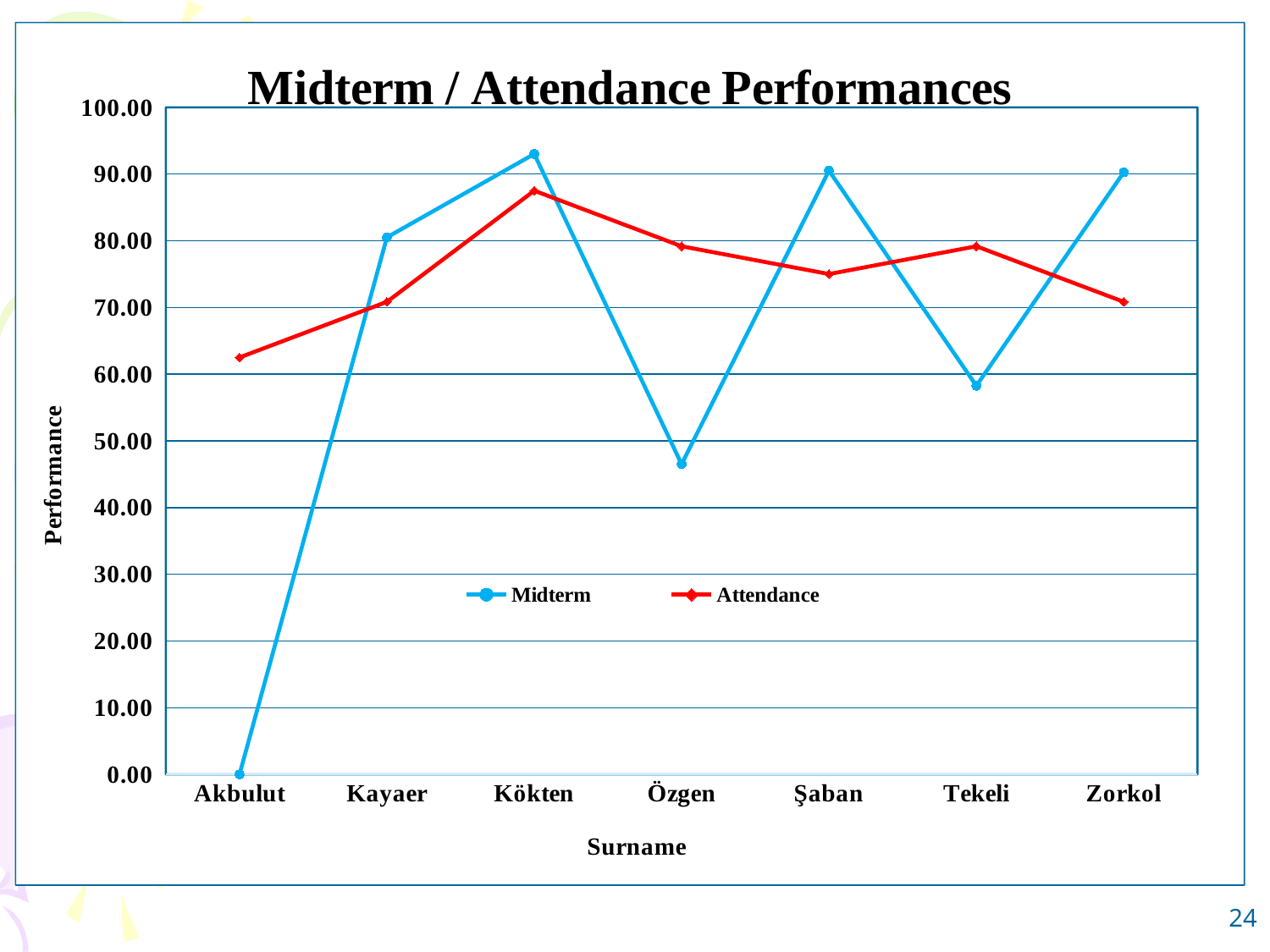
How many series does the legend list? 2 How many surnames are shown on the x axis? 7 For Özgen, which is larger: the Midterm value or the Attendance value? Attendance Is the Midterm value for Özgen greater or less than 50.00? less Which surname has the lowest Midterm value? Akbulut Which surname has the highest Midterm value? Kökten What is the title of the chart? Midterm / Attendance Performances Is the Attendance value for Kökten greater or less than 80.00? greater What is the Midterm value for Akbulut? 0.00 What kind of chart is shown on the slide? line chart Which surname has the lowest Attendance value? Akbulut Which surname has the highest Attendance value? Kökten